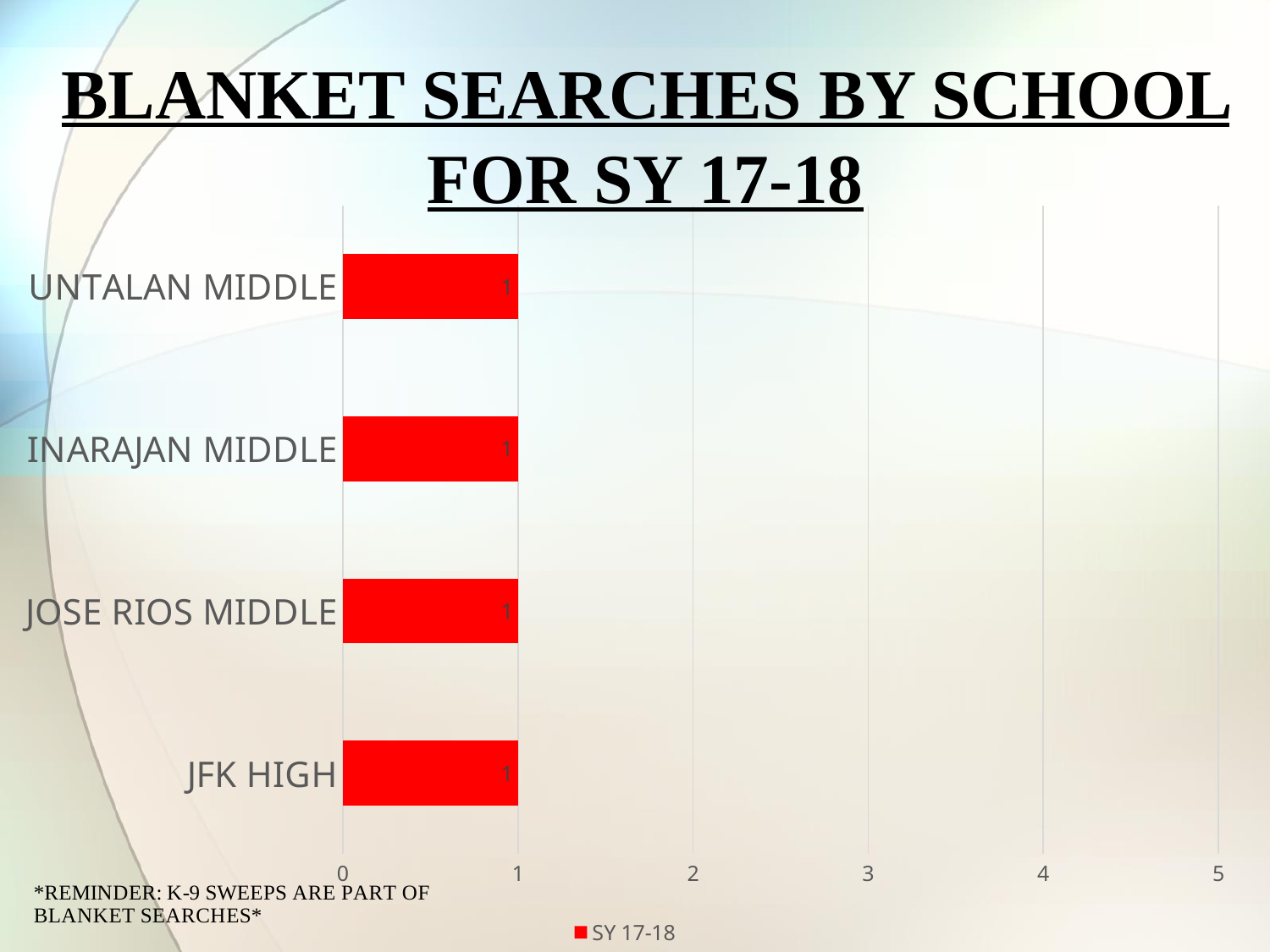
What is the value for JOSE RIOS MIDDLE? 1 What kind of chart is shown on the slide? bar chart What is the difference between the values for JFK HIGH and UNTALAN MIDDLE? 0 What is the total of the values for all four schools? 4 How many series does the legend list? 1 What is the value for UNTALAN MIDDLE? 1 What is the value for INARAJAN MIDDLE? 1 What is the value for JFK HIGH? 1 What colour are the bars in the chart? red How many schools are shown in the chart? 4 What series name is shown in the legend? SY 17-18 Is the value for JOSE RIOS MIDDLE greater or less than 2? less